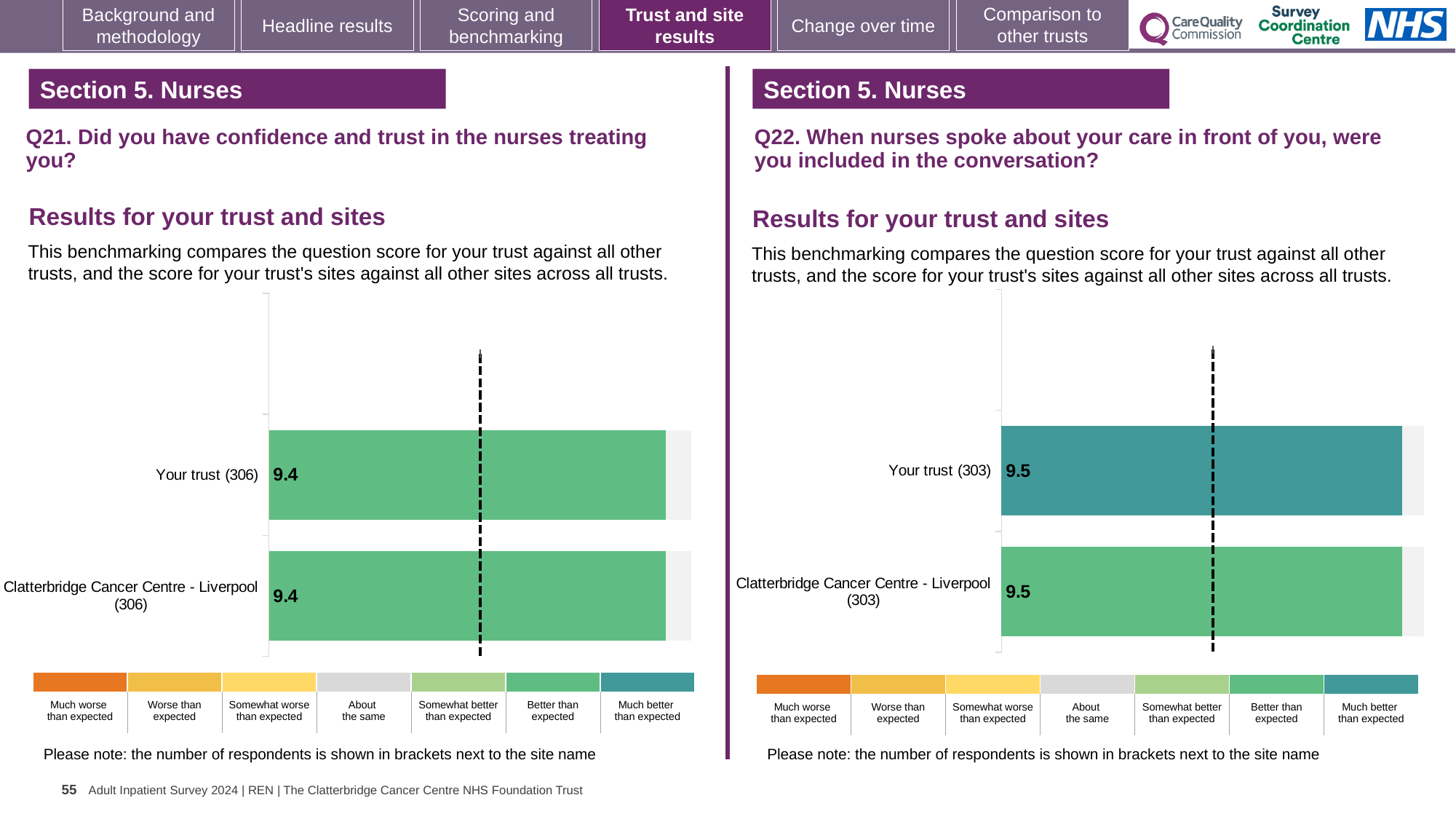
On the Q22 chart (right), what is the difference between the score for Your trust and the score for Clatterbridge Cancer Centre - Liverpool? 0 On the Q21 chart (left), what is the difference between the score for Your trust and the score for Clatterbridge Cancer Centre - Liverpool? 0 How many bars are plotted on the Q22 chart (right)? 2 What type of chart is used on the Q21 chart (left)? Bar chart On the Q21 chart (left), what is the score for Clatterbridge Cancer Centre - Liverpool (306)? 9.4 How many bars are plotted on the Q21 chart (left)? 2 On the Q21 chart (left), which benchmark category does the colour of the Your trust (306) bar correspond to in the legend? Better than expected On the Q22 chart (right), what is the score for Clatterbridge Cancer Centre - Liverpool (303)? 9.5 How many respondents are shown in brackets for Your trust on the Q22 chart (right)? 303 On the Q22 chart (right), which benchmark category does the colour of the Your trust (303) bar correspond to in the legend? Much better than expected On the Q21 chart (left), what is the score for Your trust (306)? 9.4 On the Q22 chart (right), what is the score for Your trust (303)? 9.5